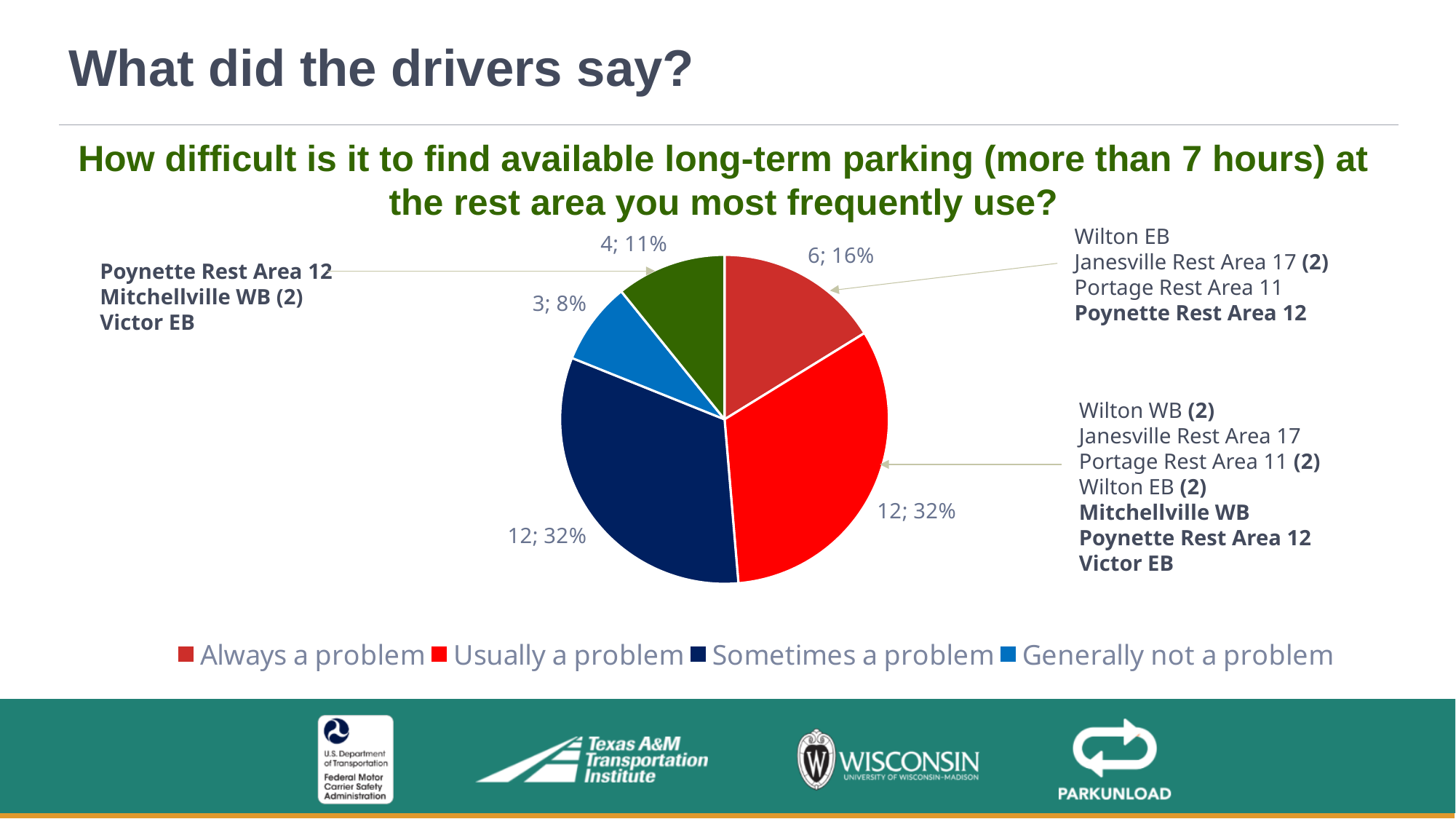
What is the count and percentage shown for the 'Generally not a problem' slice? 3; 8% Which legend category has the smallest slice of the pie? Generally not a problem How many entries does the legend list? 4 What is the count and percentage shown for the 'Always a problem' slice? 6; 16% How many slices does the pie chart have? 5 What kind of chart is shown on the slide? pie chart What is the difference in count between the 'Usually a problem' slice and the 'Always a problem' slice? 6 What percentage of responses is 'Usually a problem'? 32% What percentage is shown for the green slice at the top of the pie? 11% What colour is the 'Sometimes a problem' slice? dark blue How many responses are in the 'Sometimes a problem' slice? 12 Which is larger, the 'Always a problem' slice or the 'Generally not a problem' slice? Always a problem